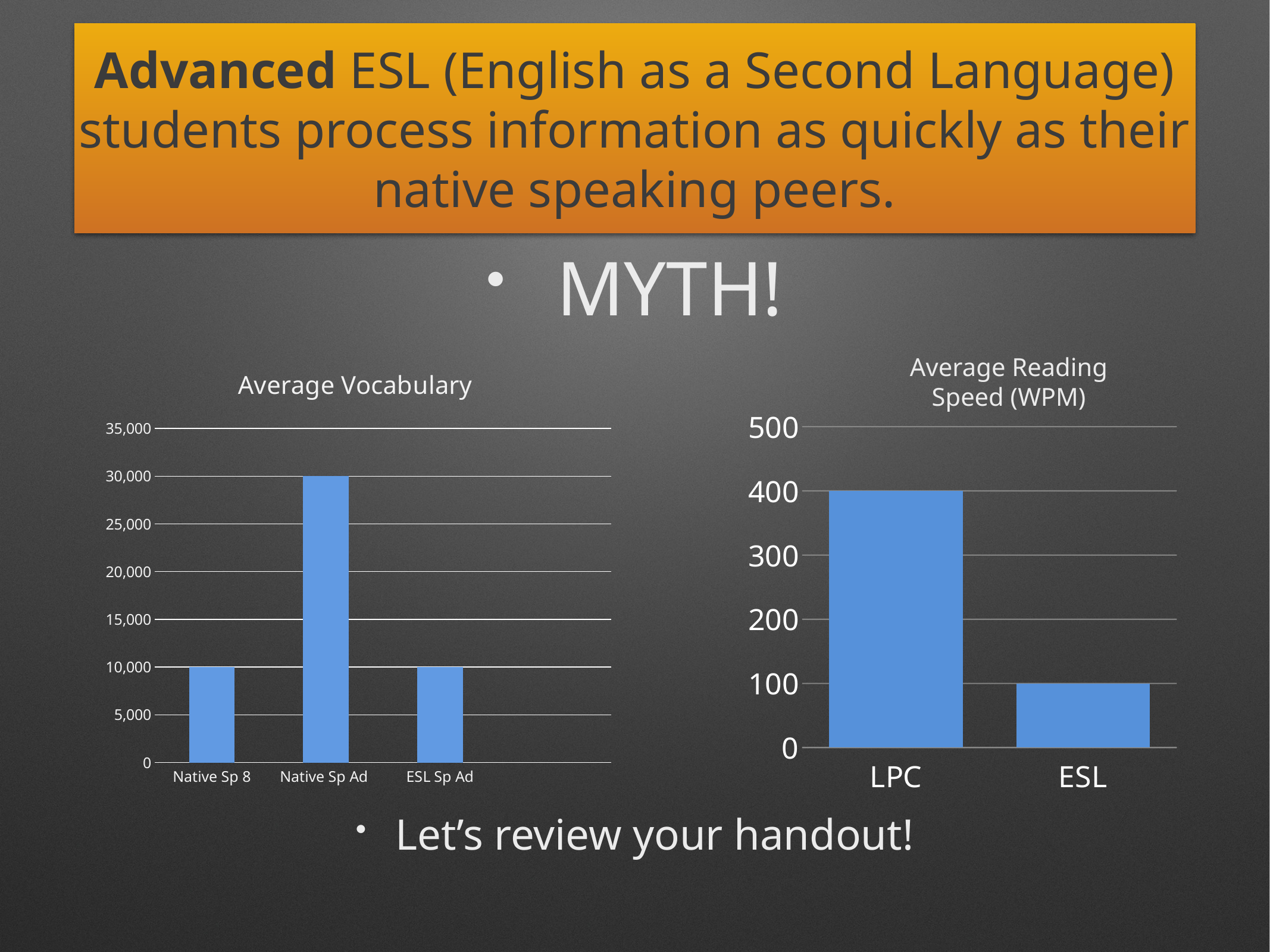
In the Average Reading Speed (WPM) chart, which category has the lowest value? ESL In the Average Reading Speed (WPM) chart, what is the value for ESL? 100 In the Average Reading Speed (WPM) chart, what is the difference between LPC and ESL? 300 What is the title of the chart on the left side of the slide? Average Vocabulary In the Average Vocabulary chart, what is the value for Native Sp Ad? 30,000 In the Average Vocabulary chart, what is the difference between Native Sp Ad and ESL Sp Ad? 20,000 In the Average Vocabulary chart, is the value for ESL Sp Ad greater or less than 15,000? less What kind of chart is the Average Reading Speed (WPM) chart? bar chart In the Average Vocabulary chart, what is the value for Native Sp 8? 10,000 In the Average Vocabulary chart, which category has the highest value? Native Sp Ad In the Average Reading Speed (WPM) chart, what is the value for LPC? 400 In the Average Vocabulary chart, how many categories are shown? 3